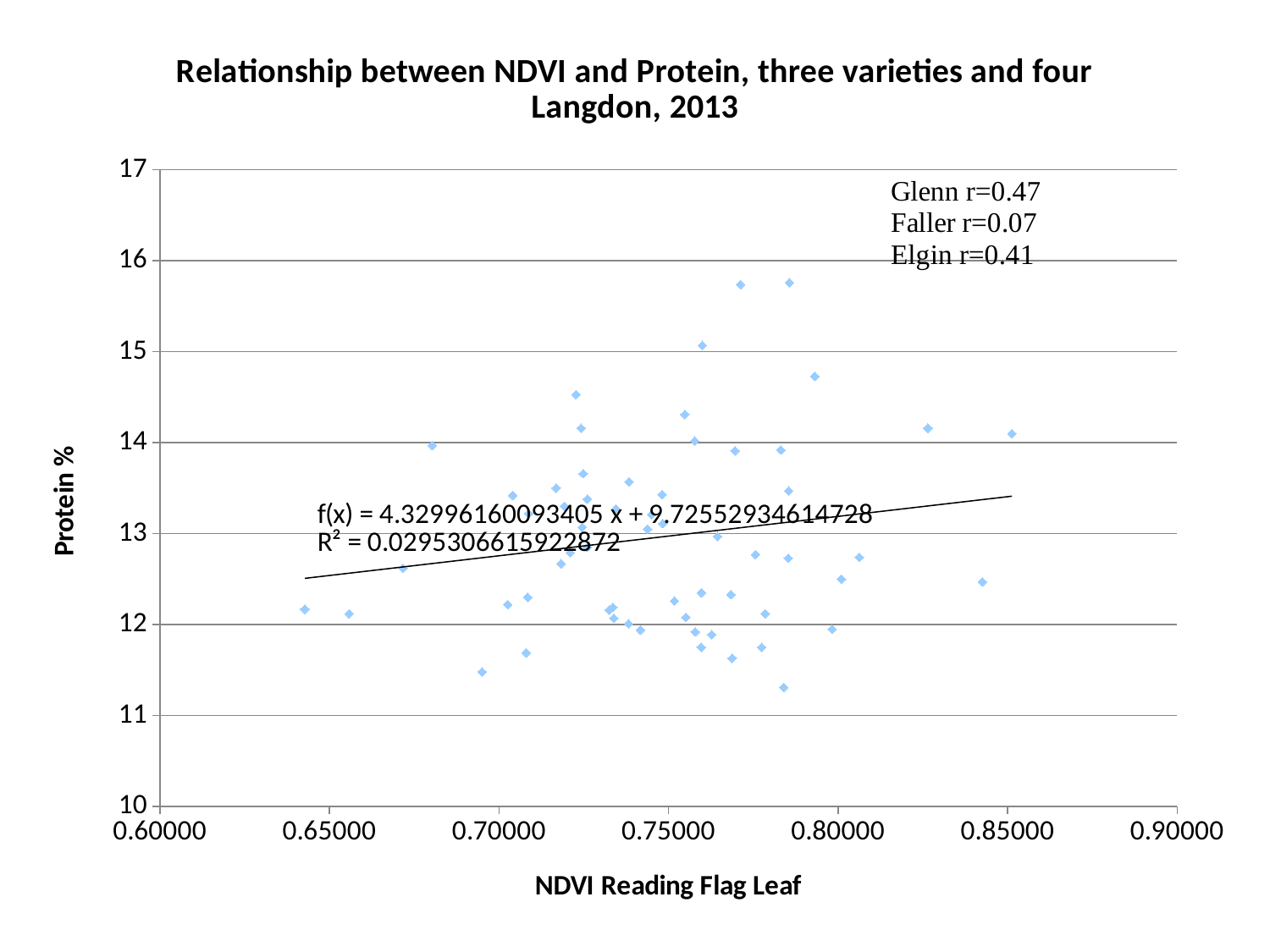
What correlation coefficient r is given for Glenn? r=0.47 Is the lowest Protein % value plotted greater or less than 12? less What kind of chart is shown on the slide? Scatter chart What correlation coefficient r is given for Faller? r=0.07 Is the highest Protein % value plotted greater or less than 15? greater Does the fitted trendline rise or fall as NDVI Reading Flag Leaf increases? Rises Which variety has the lowest correlation coefficient listed on the chart? Faller What is the slope of the trendline equation shown on the chart? 4.32996160093405 What is the R² value shown for the trendline? 0.0295306615922872 What is the title of the chart? Relationship between NDVI and Protein, three varieties and four Langdon, 2013 What is the intercept of the trendline equation shown on the chart? 9.72552934614728 What is the label of the y axis? Protein %